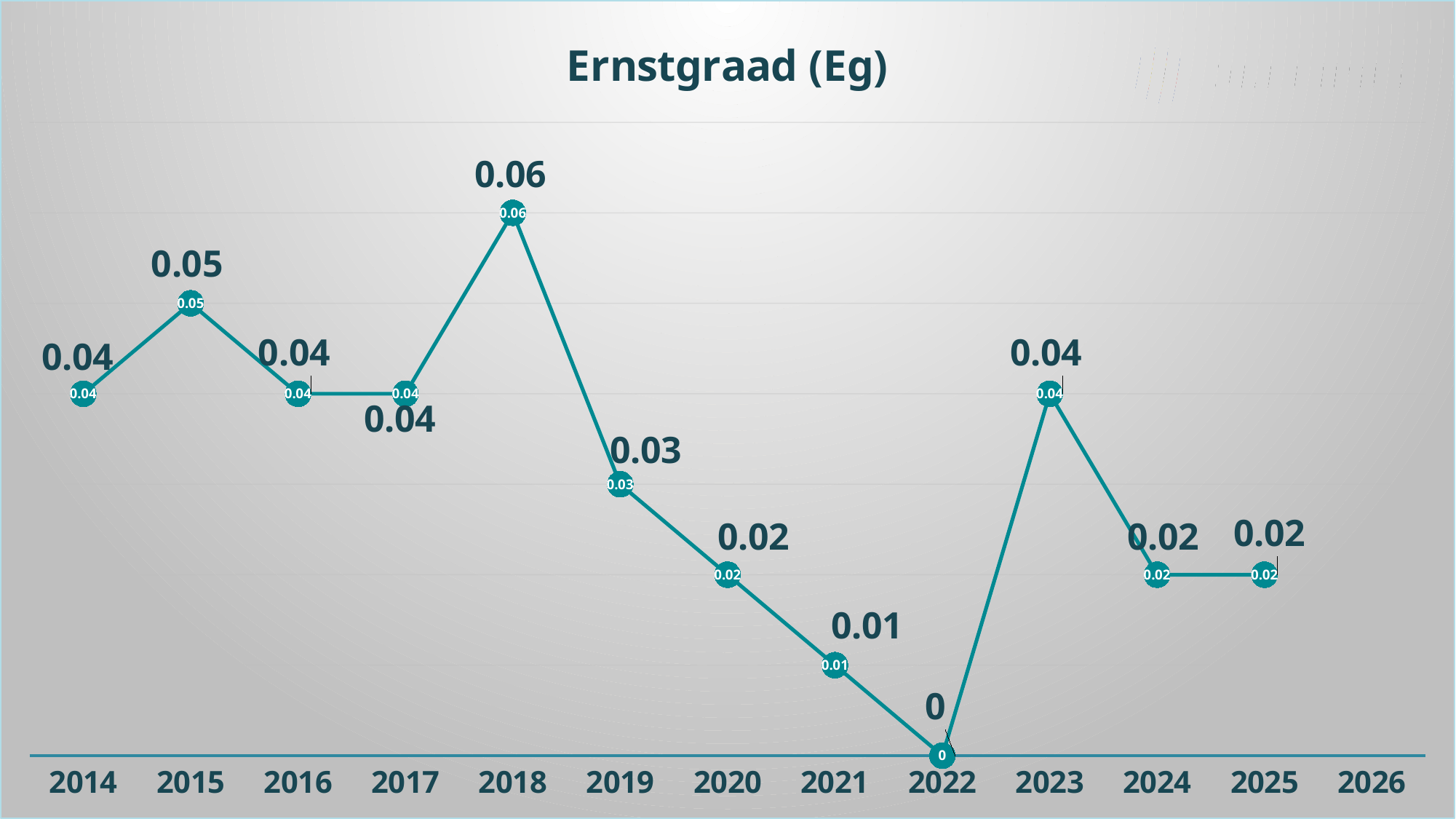
What is the difference between the values for 2023 and 2024? 0.02 What is the value for 2023? 0.04 What kind of chart is shown? line chart What is the title of the chart? Ernstgraad (Eg) What is the value for 2022? 0 What is the value for 2018? 0.06 Which year has the lowest value? 2022 Which is larger, the value for 2015 or the value for 2021? 2015 What is the value for 2015? 0.05 How many data points are plotted on the line? 12 What is the difference between the values for 2018 and 2019? 0.03 Which year has the highest value? 2018